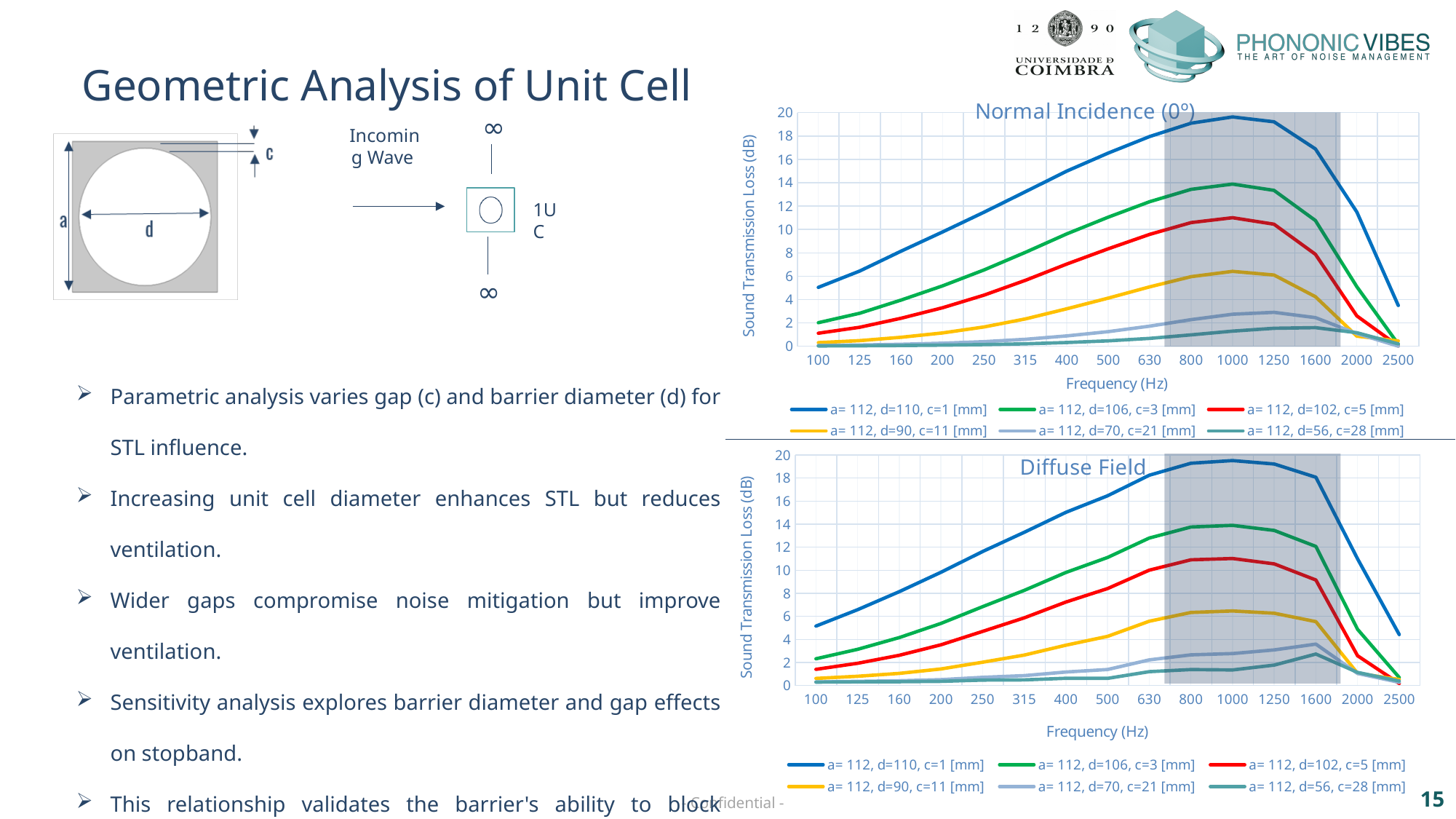
How many frequency points are shown on the x axis of the Normal Incidence (0°) chart? 15 In the Normal Incidence (0°) chart, is the value for the a= 112, d=106, c=3 [mm] series at 1000 Hz greater or less than 12? greater What kind of chart is the Normal Incidence (0°) chart? line chart In the Diffuse Field chart, is the value for the a= 112, d=56, c=28 [mm] series at 100 Hz greater or less than 2? less How many series does the legend of the Diffuse Field chart list? 6 In the Diffuse Field chart, is the value for the a= 112, d=102, c=5 [mm] series at 1000 Hz greater or less than 8? greater In the Diffuse Field chart, at 1000 Hz, which is larger: the a= 112, d=106, c=3 [mm] series or the a= 112, d=90, c=11 [mm] series? a= 112, d=106, c=3 [mm] In the Normal Incidence (0°) chart, does the a= 112, d=110, c=1 [mm] series rise or fall from 100 Hz to 1000 Hz? rise What is the y-axis label of the Diffuse Field chart? Sound Transmission Loss (dB) In the Normal Incidence (0°) chart, which series has the highest value at 1000 Hz? a= 112, d=110, c=1 [mm] In the Diffuse Field chart, which series has the lowest value at 1000 Hz? a= 112, d=56, c=28 [mm]